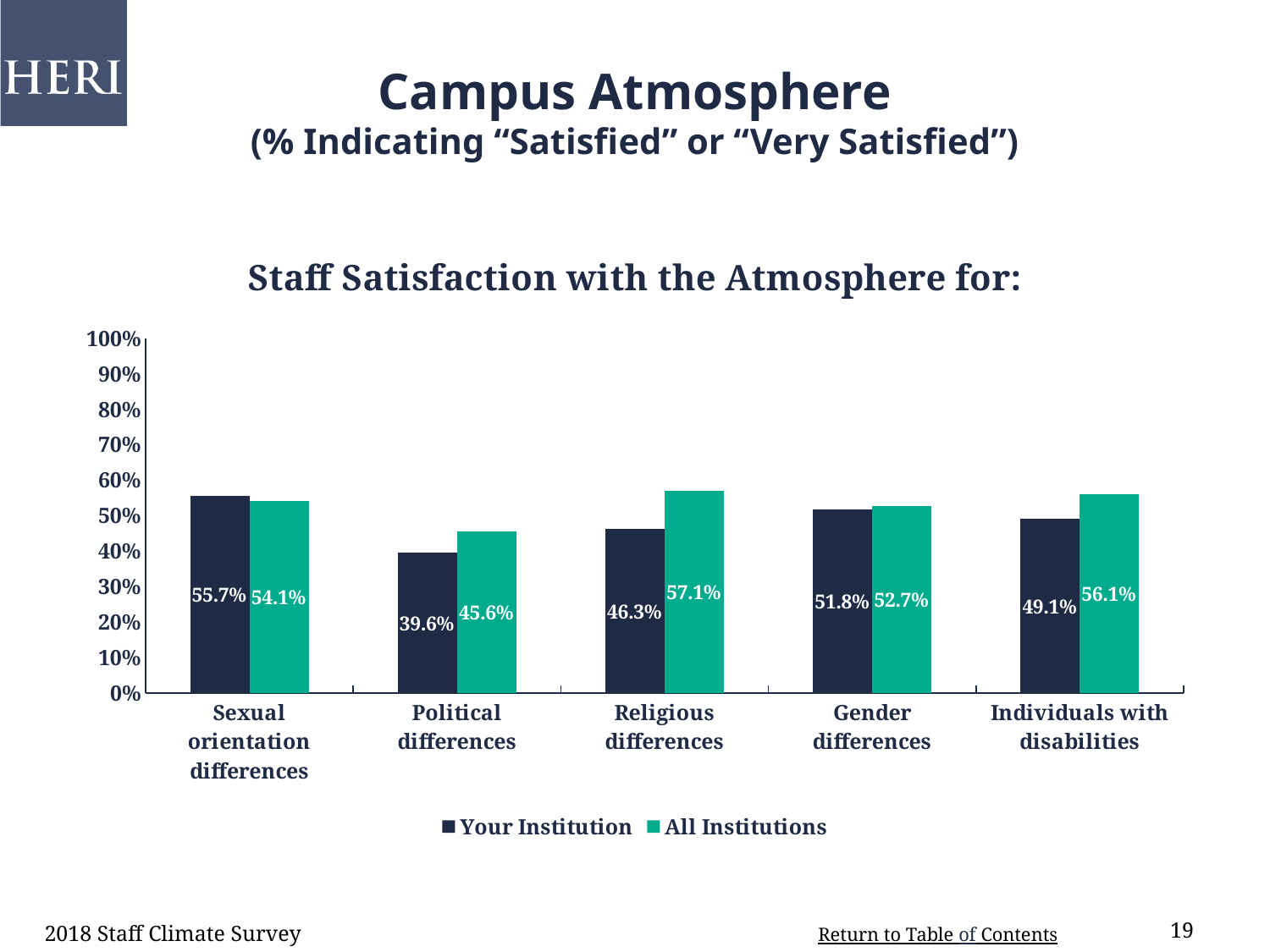
Is the value for Your Institution for Gender differences greater or less than 50%? greater What is the value for All Institutions for Religious differences? 57.1% Which category has the lowest value for All Institutions? Political differences What is the difference between All Institutions and Your Institution for Religious differences? 10.8% What is the value for Your Institution for Political differences? 39.6% Which is larger for Sexual orientation differences: Your Institution or All Institutions? Your Institution What kind of chart is shown on the slide? Bar chart Which category has the highest value for Your Institution? Sexual orientation differences What is the title of the chart? Staff Satisfaction with the Atmosphere for: How many series does the legend list? 2 What is the value for Your Institution for Individuals with disabilities? 49.1% How many categories are shown on the x axis? 5